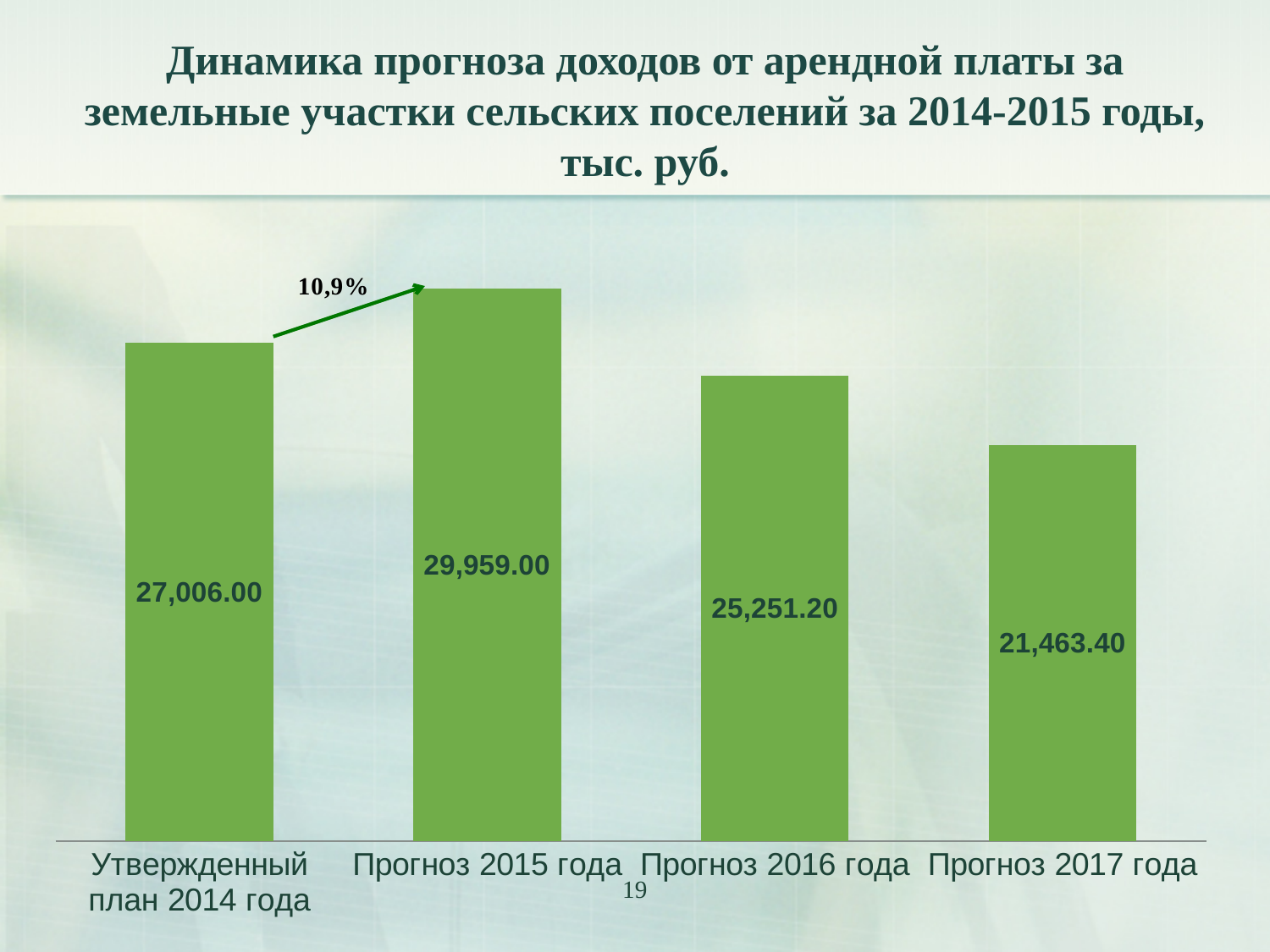
What is the value for Утвержденный план 2014 года? 27,006.00 Which category has the highest value? Прогноз 2015 года What is the difference between Прогноз 2015 года and Утвержденный план 2014 года? 2,953.00 What kind of chart is shown on the slide? Bar chart What percentage change is annotated by the arrow between Утвержденный план 2014 года and Прогноз 2015 года? 10,9% What is the value for Прогноз 2017 года? 21,463.40 Which is larger, Утвержденный план 2014 года or Прогноз 2016 года? Утвержденный план 2014 года What is the value for Прогноз 2016 года? 25,251.20 What is the value for Прогноз 2015 года? 29,959.00 What is the difference between Прогноз 2016 года and Прогноз 2017 года? 3,787.80 Which category has the lowest value? Прогноз 2017 года How many categories are shown in the chart? 4